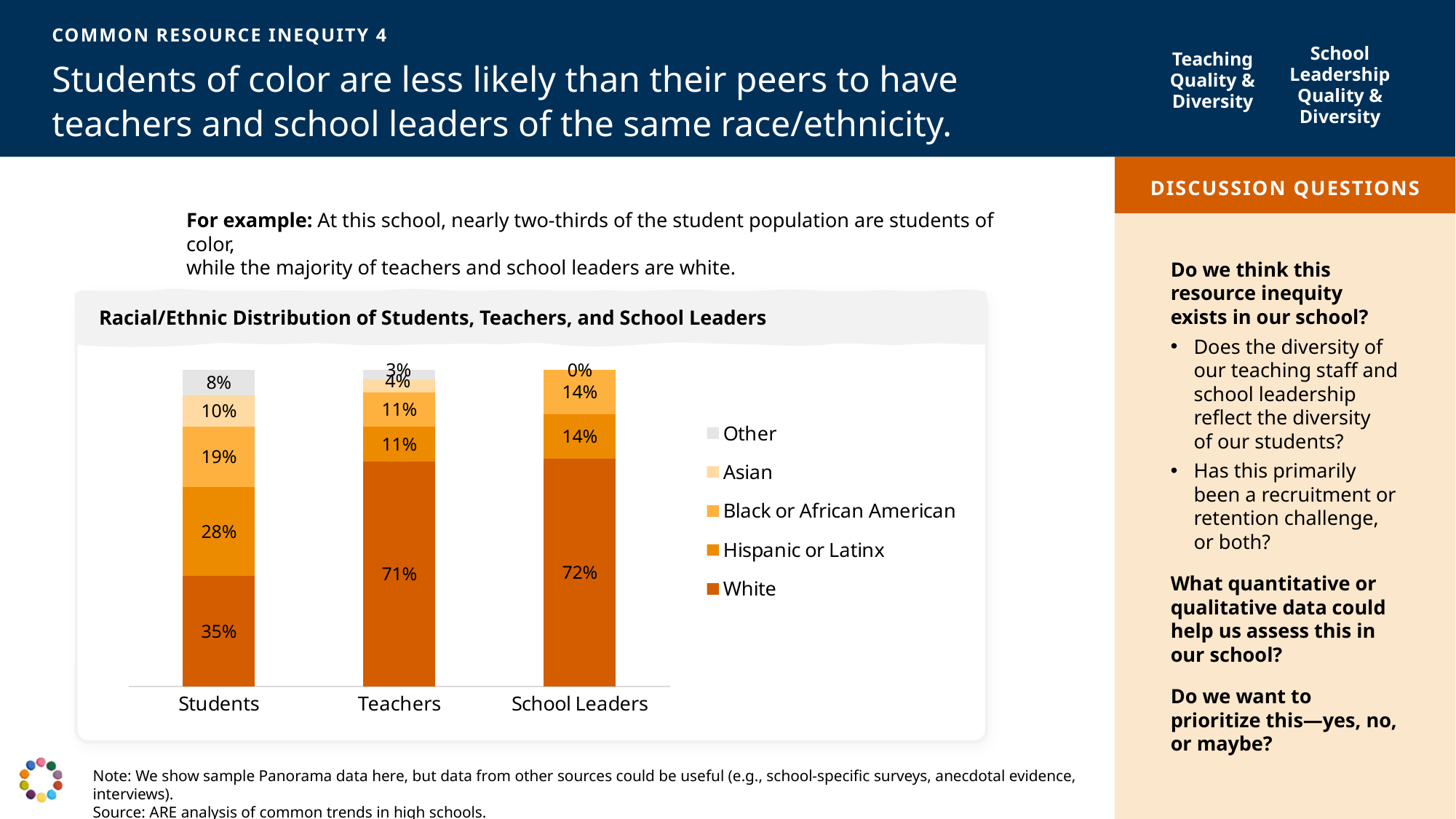
What percentage of School Leaders are Hispanic or Latinx? 14% What percentage of Students are Asian? 10% What percentage of Students fall in the Other category? 8% Which has a larger Black or African American share, Students or Teachers? Students What percentage of Students are White? 35% What kind of chart is shown on the slide? Stacked bar chart How many percentage points higher is the Hispanic or Latinx share for Students than for School Leaders? 14 percentage points Which group has the highest share of Hispanic or Latinx individuals? Students How many groups are shown on the x axis of the chart? 3 How many percentage points higher is the White share for Teachers than for Students? 36 percentage points How many series does the chart legend list? 5 What percentage of Teachers are White? 71%